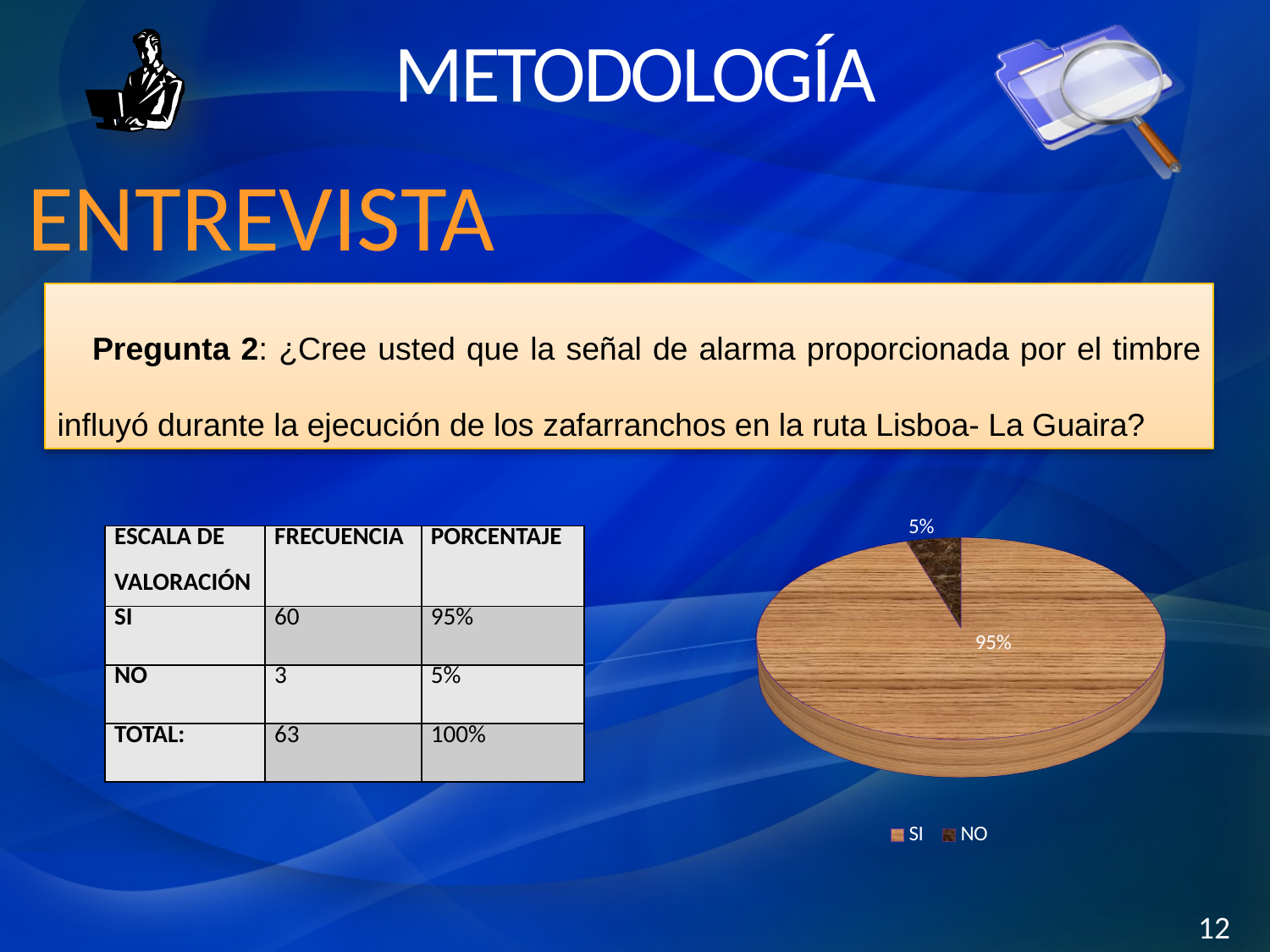
What are the legend entries of the pie chart? SI, NO What percentage does the NO slice of the pie chart show? 5% How many entries does the pie chart legend list? 2 What kind of chart is shown on the slide? pie chart What percentage does the SI slice of the pie chart show? 95% Which category has the smallest slice in the pie chart? NO What share of the pie does the SI slice represent? 95% What is the difference in percentage points between the SI and NO slices? 90 Which category has the largest slice in the pie chart? SI Which slice is larger, SI or NO? SI How many slices does the pie chart have? 2